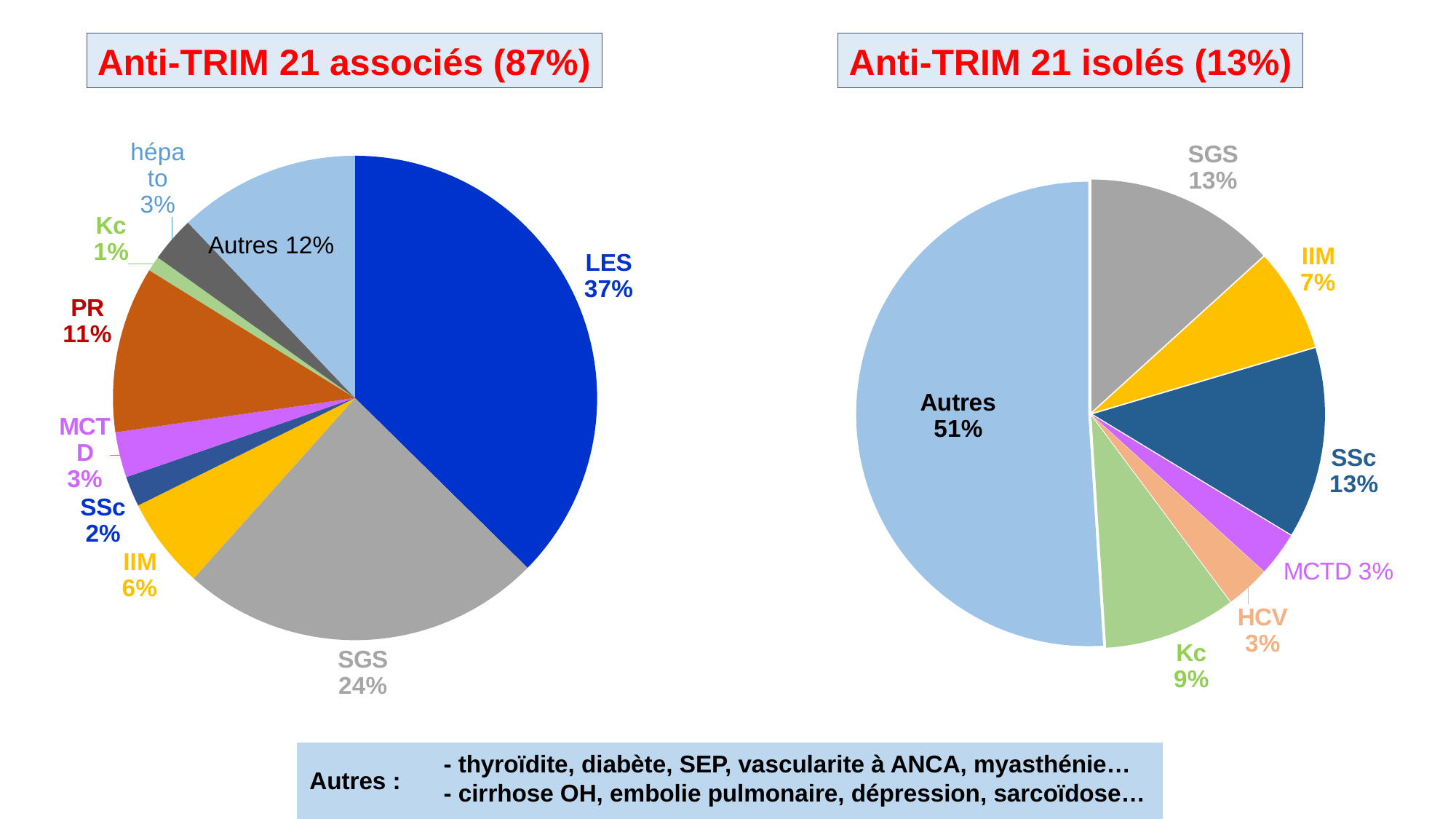
In the 'Anti-TRIM 21 associés (87%)' chart, what share does PR have? 11% What type of chart is used on the right side of the slide? Pie chart In the 'Anti-TRIM 21 isolés (13%)' chart, which is larger, IIM or Kc? Kc In the 'Anti-TRIM 21 associés (87%)' chart, which category has the largest slice? LES In the 'Anti-TRIM 21 associés (87%)' chart, what is the difference between the LES and SGS shares? 13% What is the title of the chart on the left side of the slide? Anti-TRIM 21 associés (87%) In the 'Anti-TRIM 21 isolés (13%)' chart, what share does Kc have? 9% In the 'Anti-TRIM 21 associés (87%)' chart, which category has the smallest slice? Kc In the 'Anti-TRIM 21 associés (87%)' chart, what share does LES have? 37% How many slices does the 'Anti-TRIM 21 isolés (13%)' pie chart have? 7 In the 'Anti-TRIM 21 isolés (13%)' chart, what share does Autres have? 51% How many slices does the 'Anti-TRIM 21 associés (87%)' pie chart have? 9